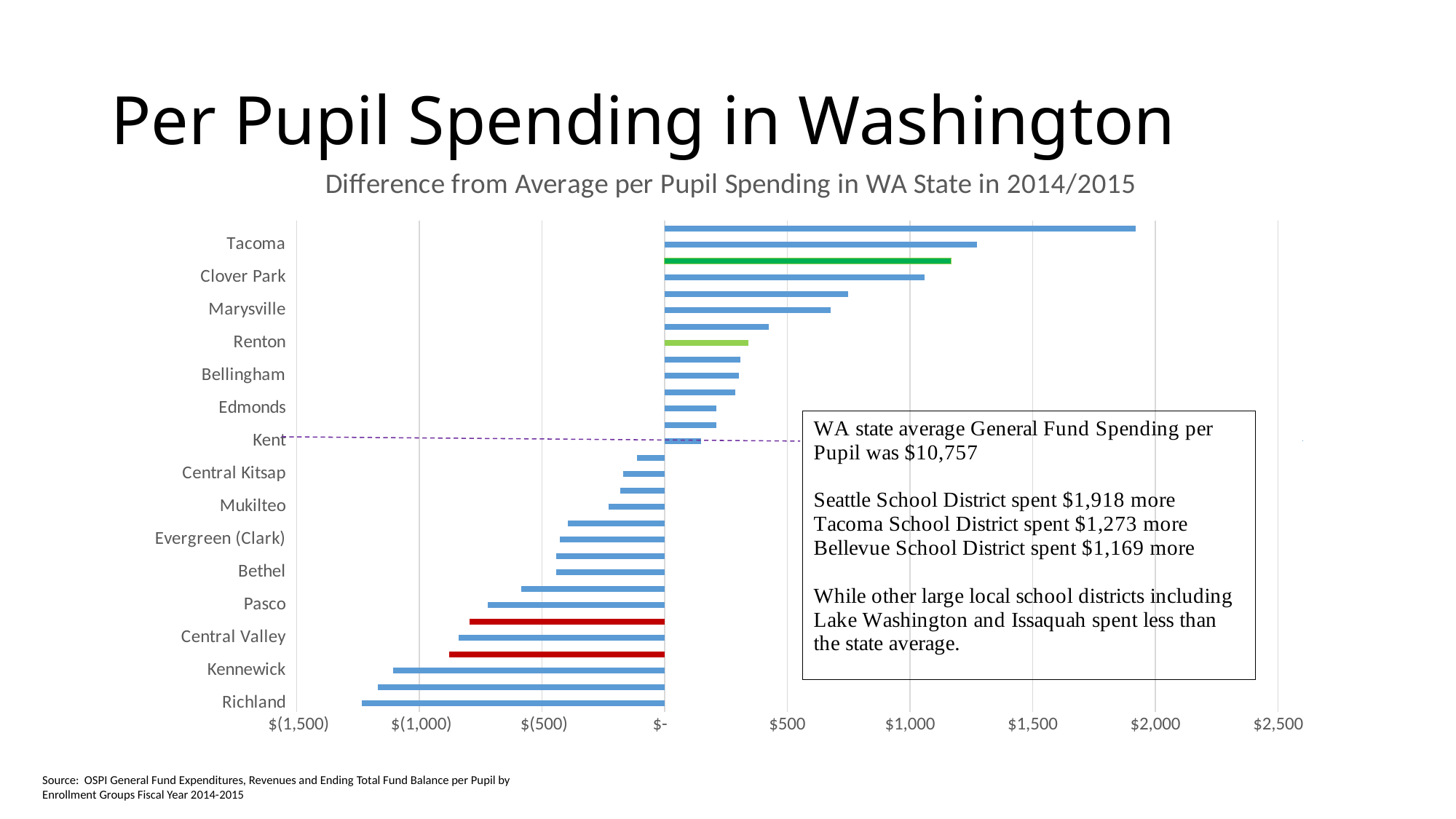
Do the bar values rise or fall going from the top of the chart to the bottom? fall Which labeled district has the lowest value (furthest below the state average)? Richland Which has the larger value, Tacoma or Clover Park? Tacoma Is the value for Richland greater or less than $(1,000)? less Is the value for Renton greater or less than $500? less What is the subtitle of the chart? Difference from Average per Pupil Spending in WA State in 2014/2015 According to the slide, what was the WA state average General Fund Spending per Pupil? $10,757 According to the slide, how much more than the state average did Tacoma School District spend per pupil? $1,273 What kind of chart is shown on the slide? bar chart Is the value for Marysville greater or less than $500? greater Which has the larger value, Bethel or Pasco? Bethel Which labeled district has the highest value (furthest above the state average)? Tacoma